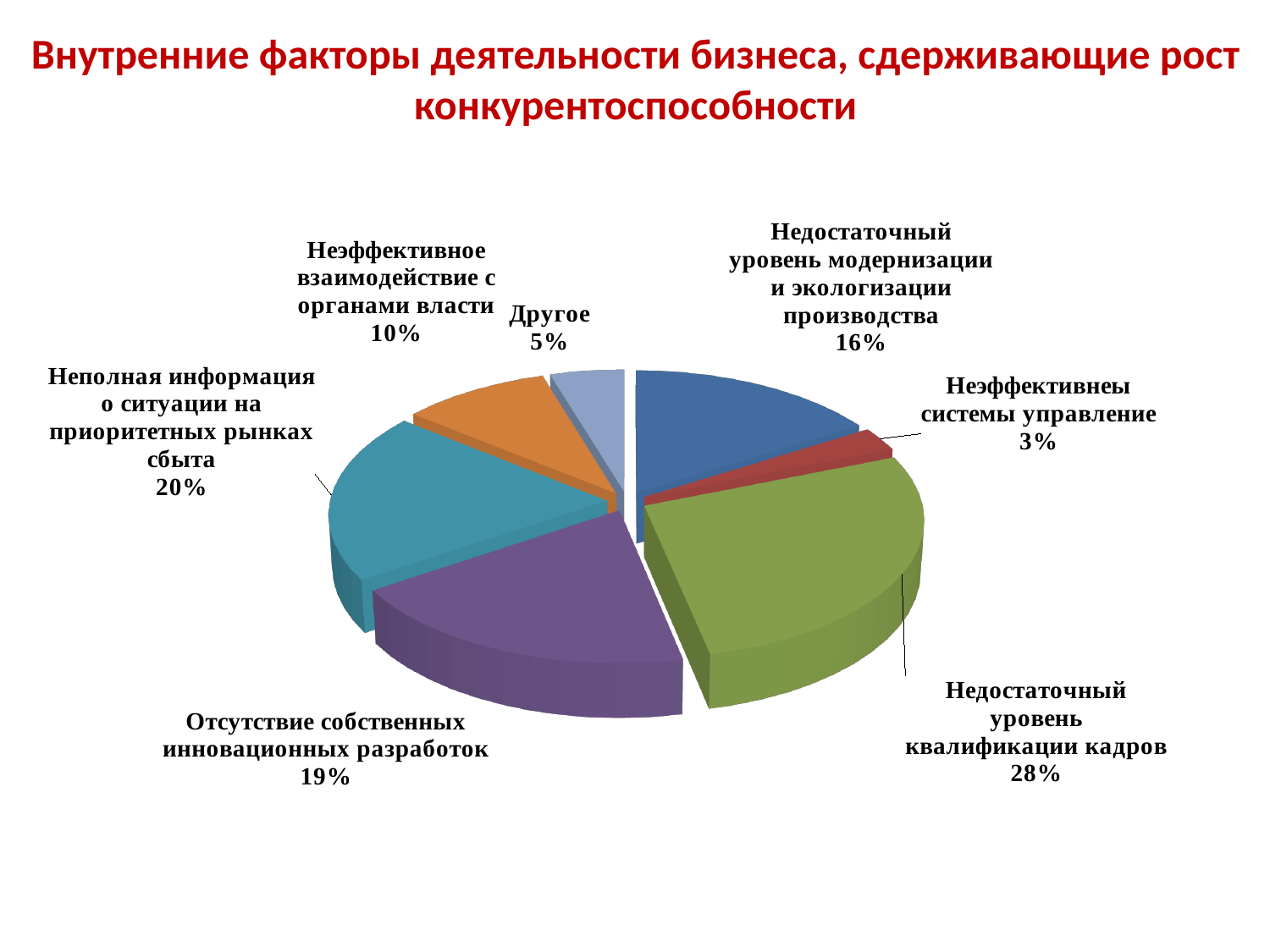
What share of the pie is "Недостаточный уровень квалификации кадров"? 28% Which category has the largest share of the pie? Недостаточный уровень квалификации кадров What is the difference between the shares of "Недостаточный уровень квалификации кадров" and "Неэффективное взаимодействие с органами власти"? 18% What share of the pie is "Недостаточный уровень модернизации и экологизации производства"? 16% What share of the pie is "Другое"? 5% How many slices does the pie chart have? 7 What is the title of the slide containing the pie chart? Внутренние факторы деятельности бизнеса, сдерживающие рост конкурентоспособности What kind of chart is shown on the slide? Pie chart Which category has the smallest share of the pie? Неэффективнеы системы управление Which is larger: the share of "Неполная информация о ситуации на приоритетных рынках сбыта" or the share of "Недостаточный уровень модернизации и экологизации производства"? Неполная информация о ситуации на приоритетных рынках сбыта